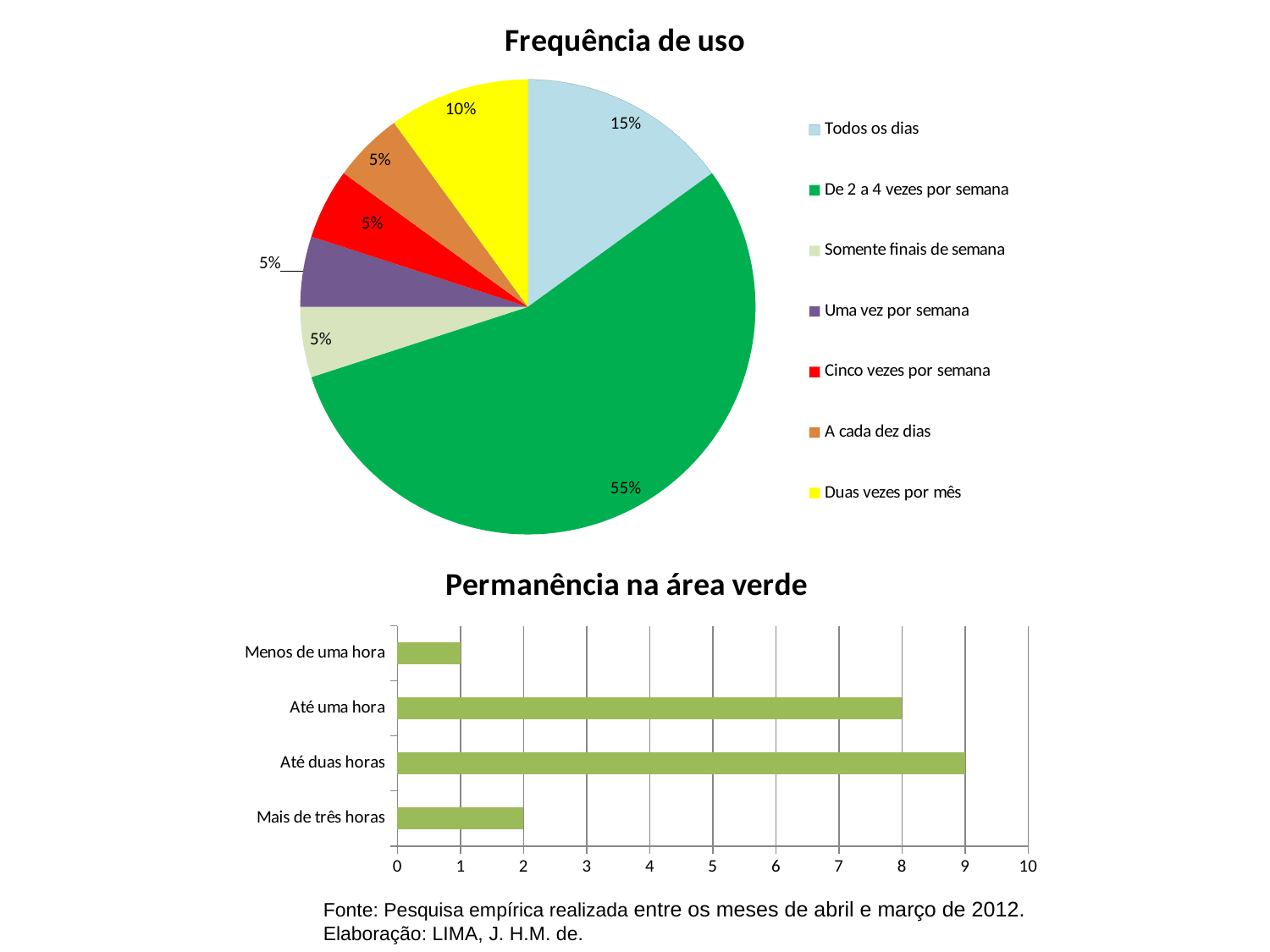
What kind of chart is 'Permanência na área verde'? Bar chart In the 'Permanência na área verde' chart, what is the value for 'Menos de uma hora'? 1 In the 'Permanência na área verde' chart, which is larger: 'Até uma hora' or 'Mais de três horas'? Até uma hora In the 'Frequência de uso' chart, how many categories does the legend list? 7 What kind of chart is 'Frequência de uso'? Pie chart In the 'Frequência de uso' chart, which category has the largest slice? De 2 a 4 vezes por semana In the 'Permanência na área verde' chart, which category has the lowest value? Menos de uma hora In the 'Frequência de uso' chart, what is the difference between the shares for 'De 2 a 4 vezes por semana' and 'Todos os dias'? 40% In the 'Frequência de uso' chart, what share is labelled for 'De 2 a 4 vezes por semana'? 55% In the 'Frequência de uso' chart, what share is labelled for 'Duas vezes por mês'? 10% In the 'Frequência de uso' chart, what share is labelled for 'Todos os dias'? 15% In the 'Permanência na área verde' chart, what is the value for 'Até duas horas'? 9